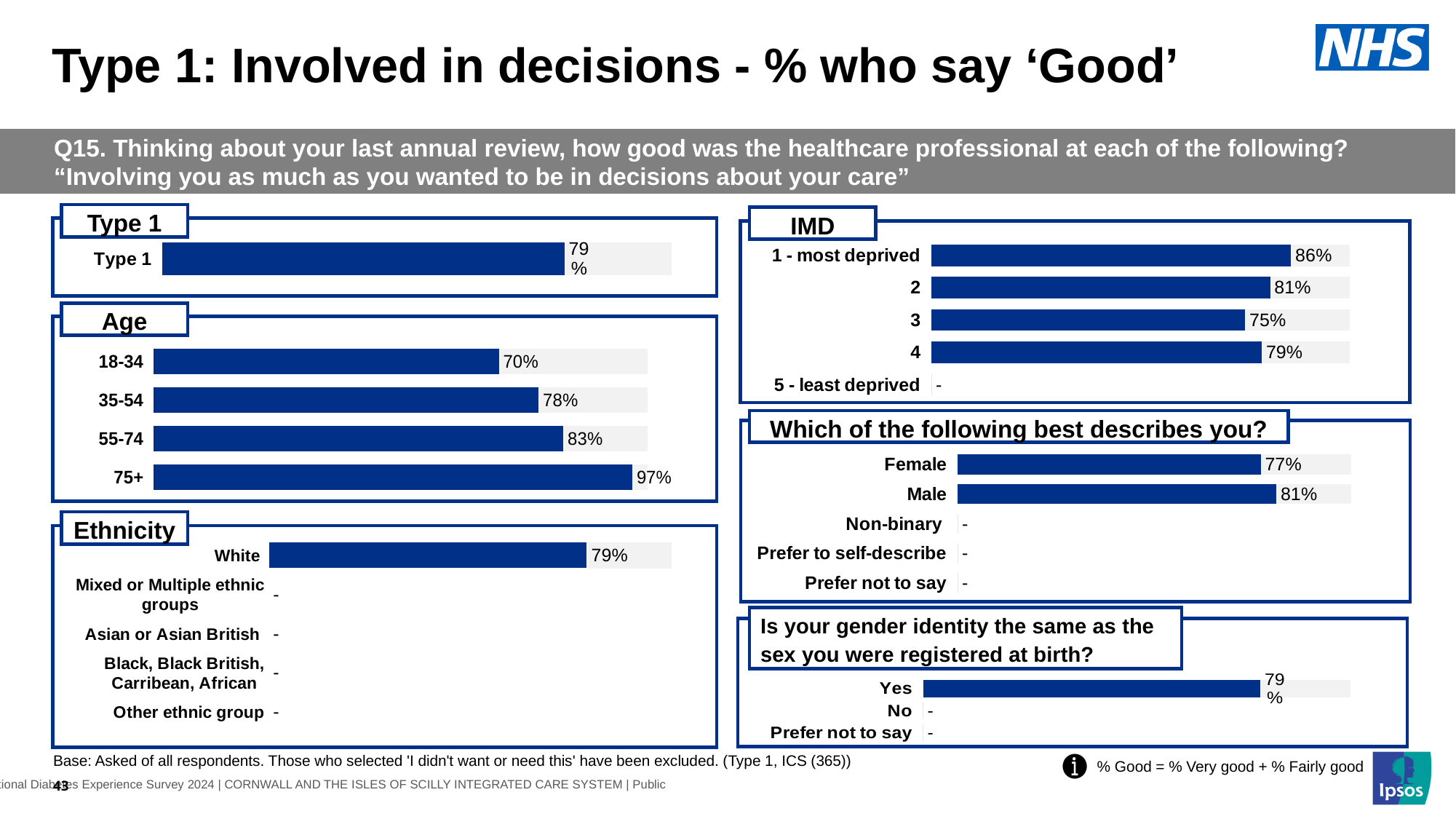
In the 'Which of the following best describes you?' chart, which is larger, Female or Male? Male In the Ethnicity chart, what is the value for White? 79% In the Age chart, what is the value for the 75+ age group? 97% In the IMD chart, which labelled group has the lowest value among those with a bar shown? 3 In the IMD chart, what is the difference between the values for group 2 and group 3? 6 percentage points In the Age chart, what is the difference between the 55-74 and 35-54 values? 5 percentage points In the 'Is your gender identity the same as the sex you were registered at birth?' chart, what is the value for Yes? 79% In the 'Which of the following best describes you?' chart, what is the value for Female? 77% In the IMD chart, what is the value for '1 - most deprived'? 86% In the Age chart, do the values rise or fall as age increases from 18-34 to 75+? rise What kind of chart is used in the Age section? bar chart In the Age chart, which age group has the lowest value? 18-34